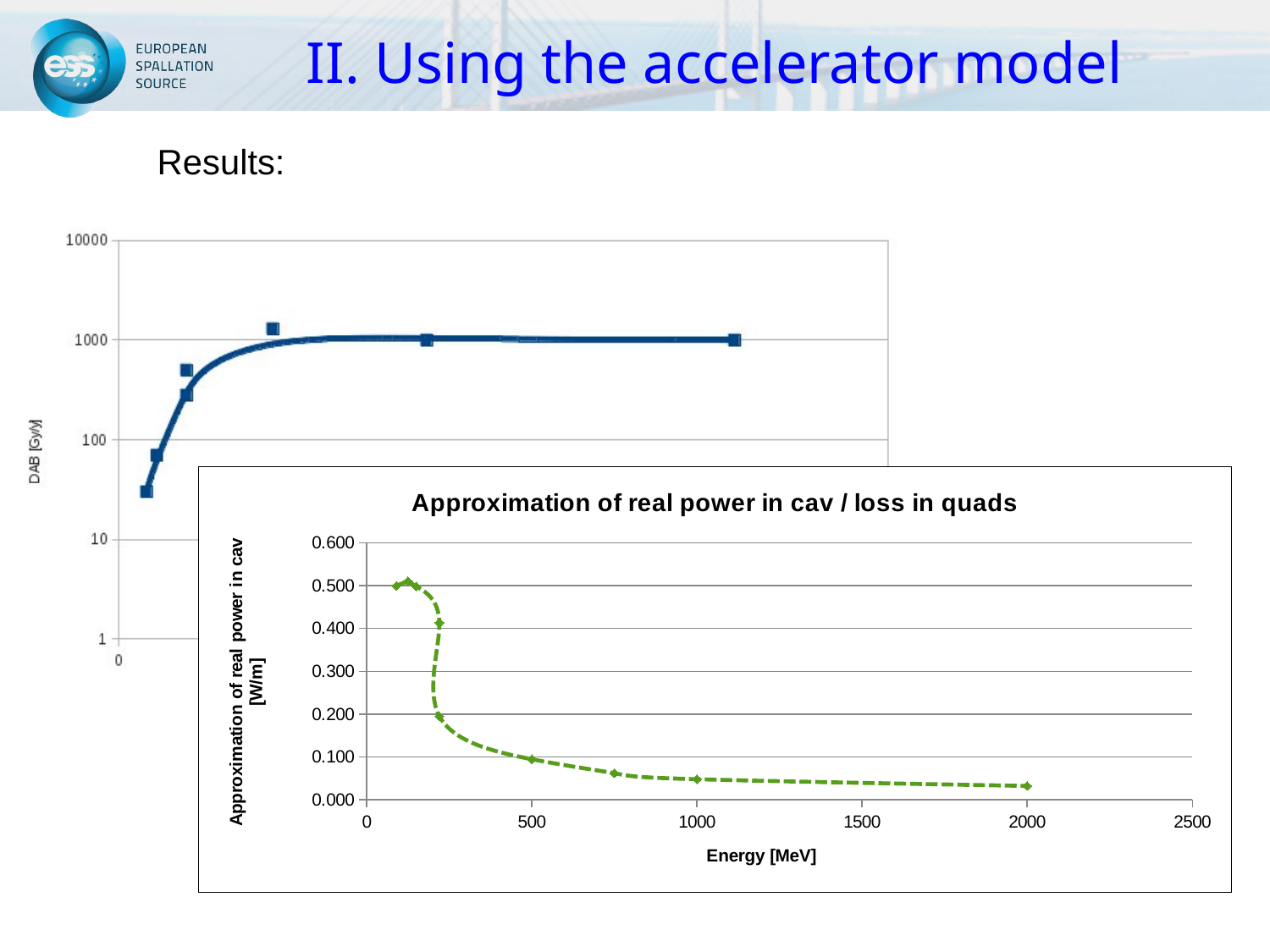
In the chart in the upper left (y axis labelled DAB [Gy/y]), do the plotted values rise or fall along the x axis before levelling off? rise In the chart titled "Approximation of real power in cav / loss in quads", is the value at 500 MeV greater or less than 0.200? less In the chart titled "Approximation of real power in cav / loss in quads", is the value at 1000 MeV greater or less than 0.100? less In the chart titled "Approximation of real power in cav / loss in quads", what is the x-axis label? Energy [MeV] In the chart titled "Approximation of real power in cav / loss in quads", what is the maximum value shown on the y axis? 0.600 In the chart titled "Approximation of real power in cav / loss in quads", what kind of chart is shown? line chart In the chart in the upper left (y axis labelled DAB [Gy/y]), is the lowest plotted point greater or less than 100? less In the chart titled "Approximation of real power in cav / loss in quads", do the values rise or fall as energy increases from 500 MeV to 2000 MeV? fall What is the title of the chart in the foreground (lower right)? Approximation of real power in cav / loss in quads In the chart titled "Approximation of real power in cav / loss in quads", which is larger, the value at 500 MeV or the value at 2000 MeV? 500 MeV